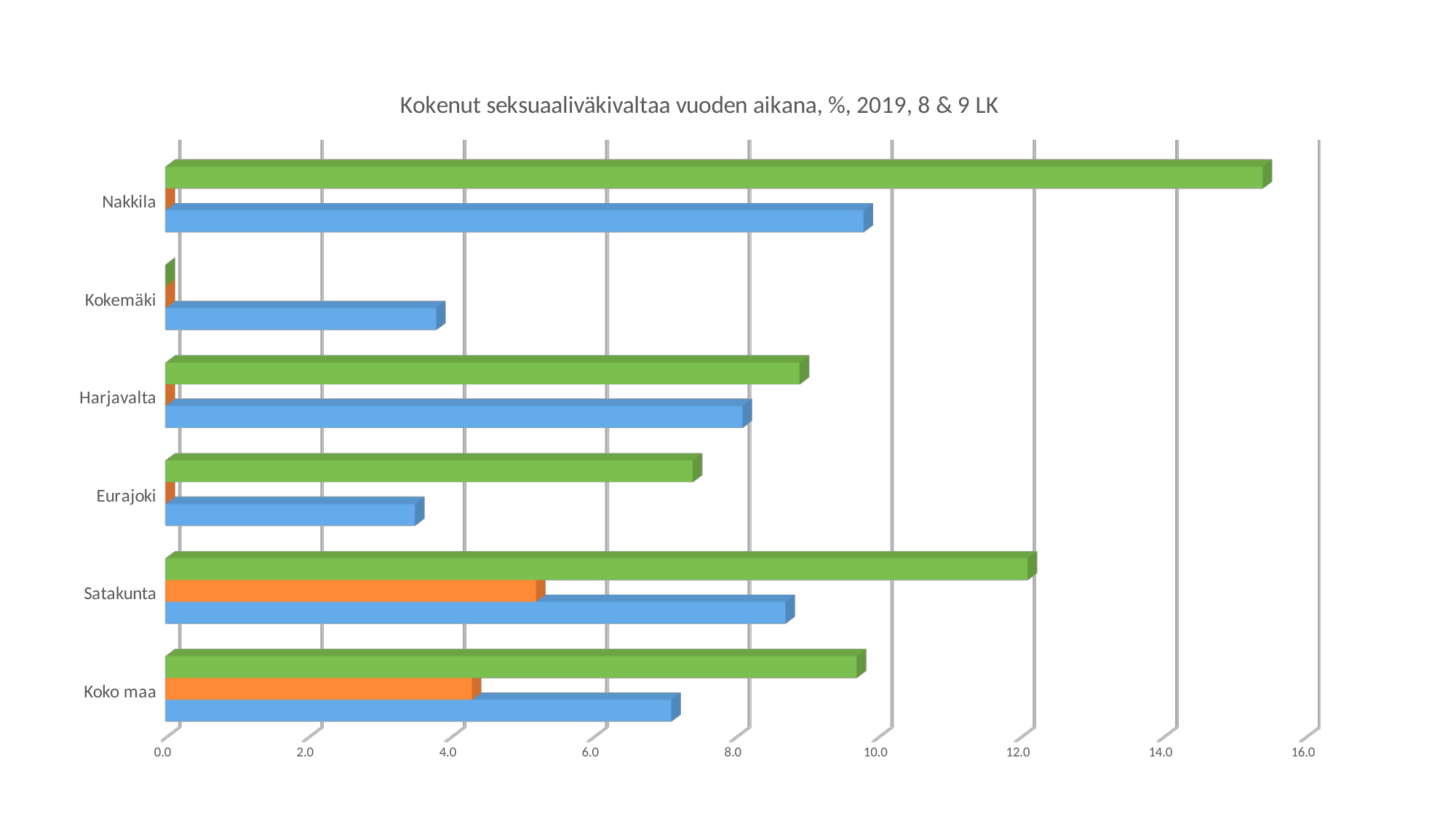
Is the blue bar for Eurajoki greater or less than 4.0? less What is the title of the chart? Kokenut seksuaaliväkivaltaa vuoden aikana, %, 2019, 8 & 9 LK What kind of chart is shown on the slide? bar chart How many categories are shown on the vertical axis of the chart? 6 Which category has the longest blue bar? Nakkila Is the green bar for Nakkila greater or less than 14.0? greater Is the orange bar for Satakunta greater or less than 4.0? greater Which category has the shortest green bar? Kokemäki Which is larger for Nakkila, the green bar or the blue bar? the green bar Which category has the longest green bar? Nakkila Which is larger, the green bar for Satakunta or the green bar for Koko maa? Satakunta